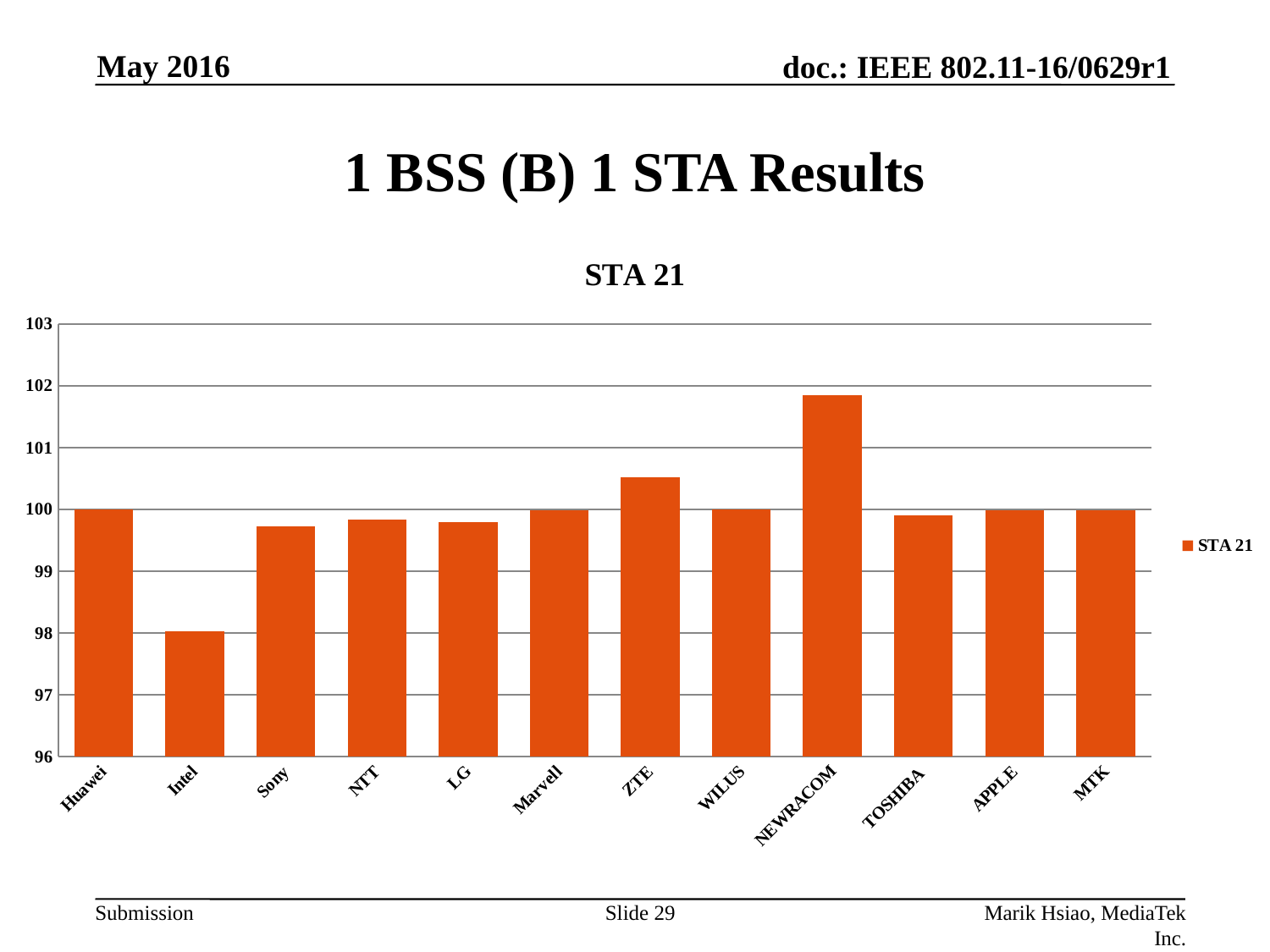
Is the value for Sony greater or less than 100? less Which has the larger value, NEWRACOM or ZTE? NEWRACOM Which category has the lowest value in the chart? Intel Which category has the highest value in the chart? NEWRACOM What kind of chart is shown on the slide? bar chart Is the value for NEWRACOM greater or less than 101? greater Is the value for Intel greater or less than 99? less What is the title of the chart? STA 21 How many series does the legend list? 1 Which has the larger value, Intel or Sony? Sony How many categories are shown on the x axis of the chart? 12